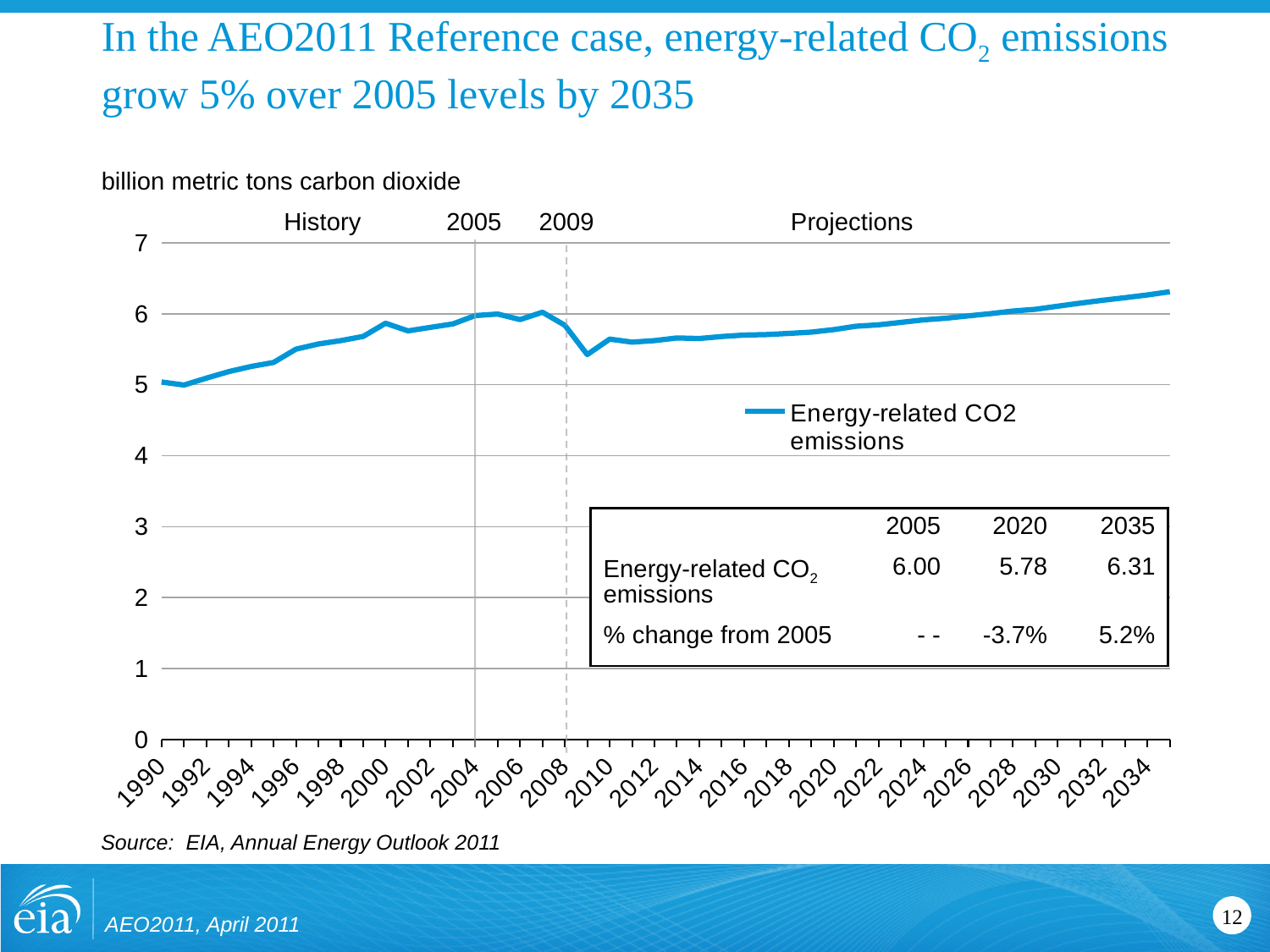
What unit is given for the y axis of the chart? billion metric tons carbon dioxide What is the value of energy-related CO2 emissions in 2035 according to the table? 6.31 Is the value for energy-related CO2 emissions in 2009 greater or less than 6? less What is the difference between the energy-related CO2 emissions values for 2035 and 2005? 0.31 What is the % change from 2005 in energy-related CO2 emissions for 2020? -3.7% What is the % change from 2005 in energy-related CO2 emissions for 2035? 5.2% What type of chart is shown on the slide? line chart How many series does the legend list? 1 What is the value of energy-related CO2 emissions in 2005 according to the table? 6.00 What is the value of energy-related CO2 emissions in 2020 according to the table? 5.78 Which is larger, the energy-related CO2 emissions value for 2005 or for 2020? 2005 Do energy-related CO2 emissions rise or fall over the projection period from 2009 to 2035? rise